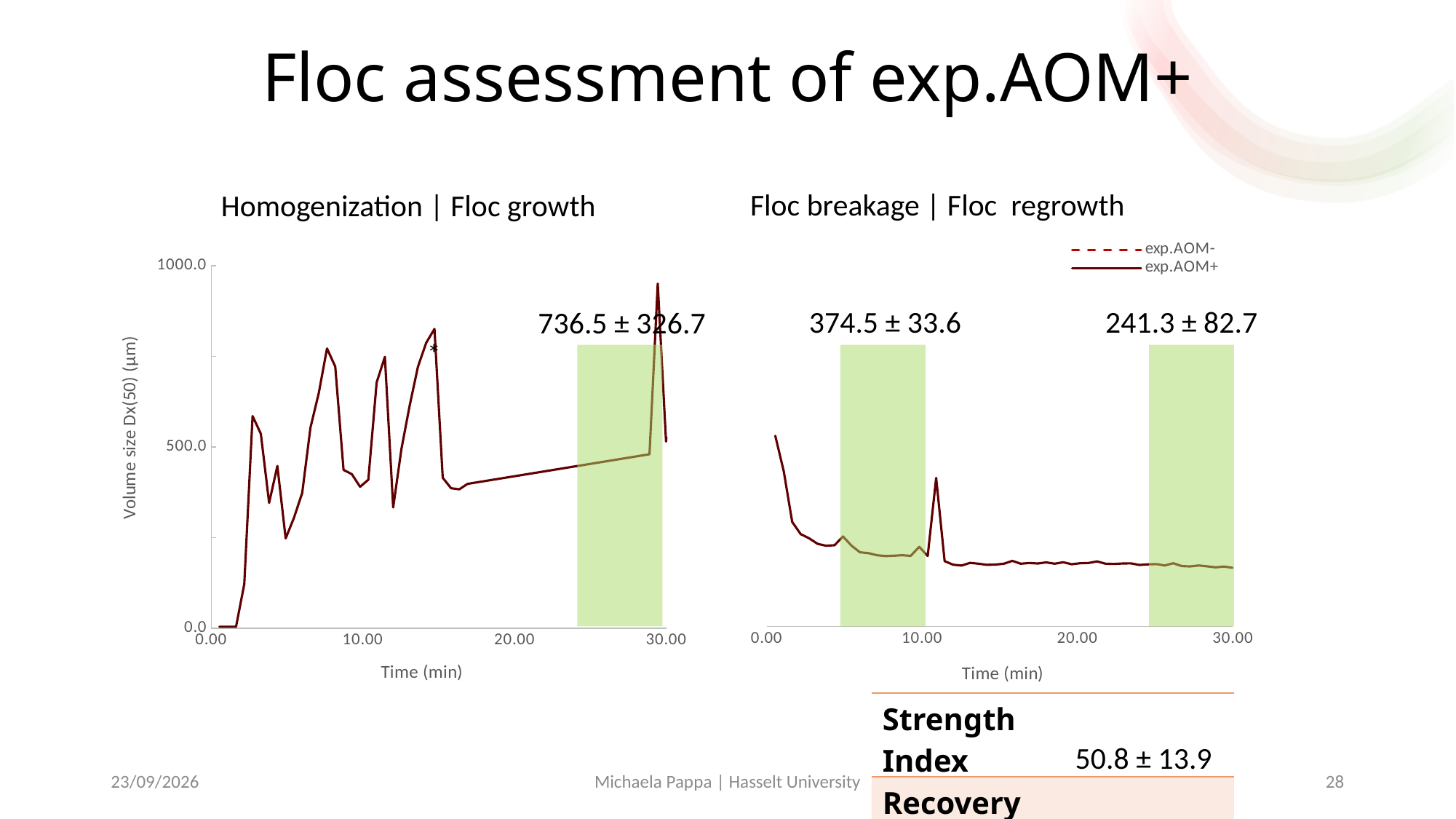
In the 'Floc breakage | Floc regrowth' chart, what value is annotated above the first shaded region? 374.5 ± 33.6 In the 'Homogenization | Floc growth' chart, is the peak value of the exp.AOM+ line near 30 minutes greater or less than 500.0? greater In the 'Floc breakage | Floc regrowth' chart, which annotated mean is larger, the first shaded region or the second shaded region? the first shaded region How many series does the legend on the slide list? 2 What are the two series names shown in the legend? exp.AOM- and exp.AOM+ In the 'Floc breakage | Floc regrowth' chart, does the exp.AOM+ line generally rise or fall between 0.00 and 5.00 minutes? fall In the 'Homogenization | Floc growth' chart, what mean value is annotated above the shaded region? 736.5 ± 326.7 What type of chart is the 'Homogenization | Floc growth' chart? line chart What is the y-axis title of the 'Homogenization | Floc growth' chart? Volume size Dx(50) (µm) In the 'Floc breakage | Floc regrowth' chart, what value is annotated above the second shaded region? 241.3 ± 82.7 In the 'Floc breakage | Floc regrowth' chart, is the exp.AOM+ value at 20.00 minutes greater or less than 500.0? less In the 'Floc breakage | Floc regrowth' chart, what is the difference between the two annotated mean values (374.5 and 241.3)? 133.2